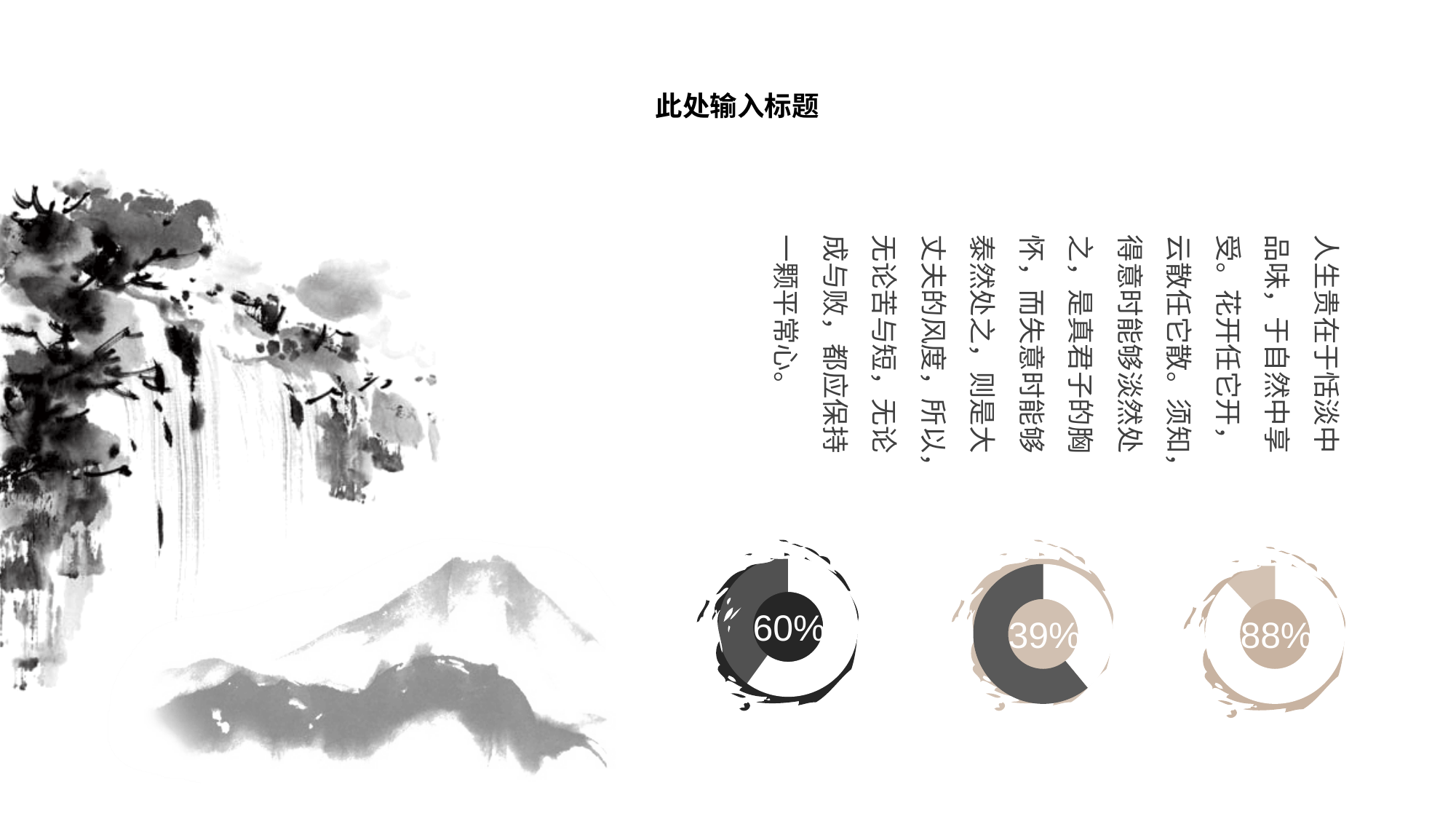
What is the title text at the top of the slide? 此处输入标题 What colour is the filled ring segment of the rightmost doughnut chart? Light brown/beige What is the difference between the value in the leftmost doughnut chart and the value in the middle doughnut chart? 21% What value is shown in the rightmost doughnut chart at the bottom of the slide? 88% Which of the three doughnut charts shows the highest percentage? The rightmost chart (88%) What value is shown in the leftmost doughnut chart at the bottom of the slide? 60% What kind of chart is used to display the percentages at the bottom of the slide? Doughnut chart How many doughnut charts are shown on the slide? 3 What value is shown in the middle doughnut chart at the bottom of the slide? 39% Is the value in the leftmost doughnut chart larger or smaller than the value in the middle doughnut chart? larger Which of the three doughnut charts shows the lowest percentage? The middle chart (39%) What is the difference between the value in the rightmost doughnut chart and the value in the leftmost doughnut chart? 28%